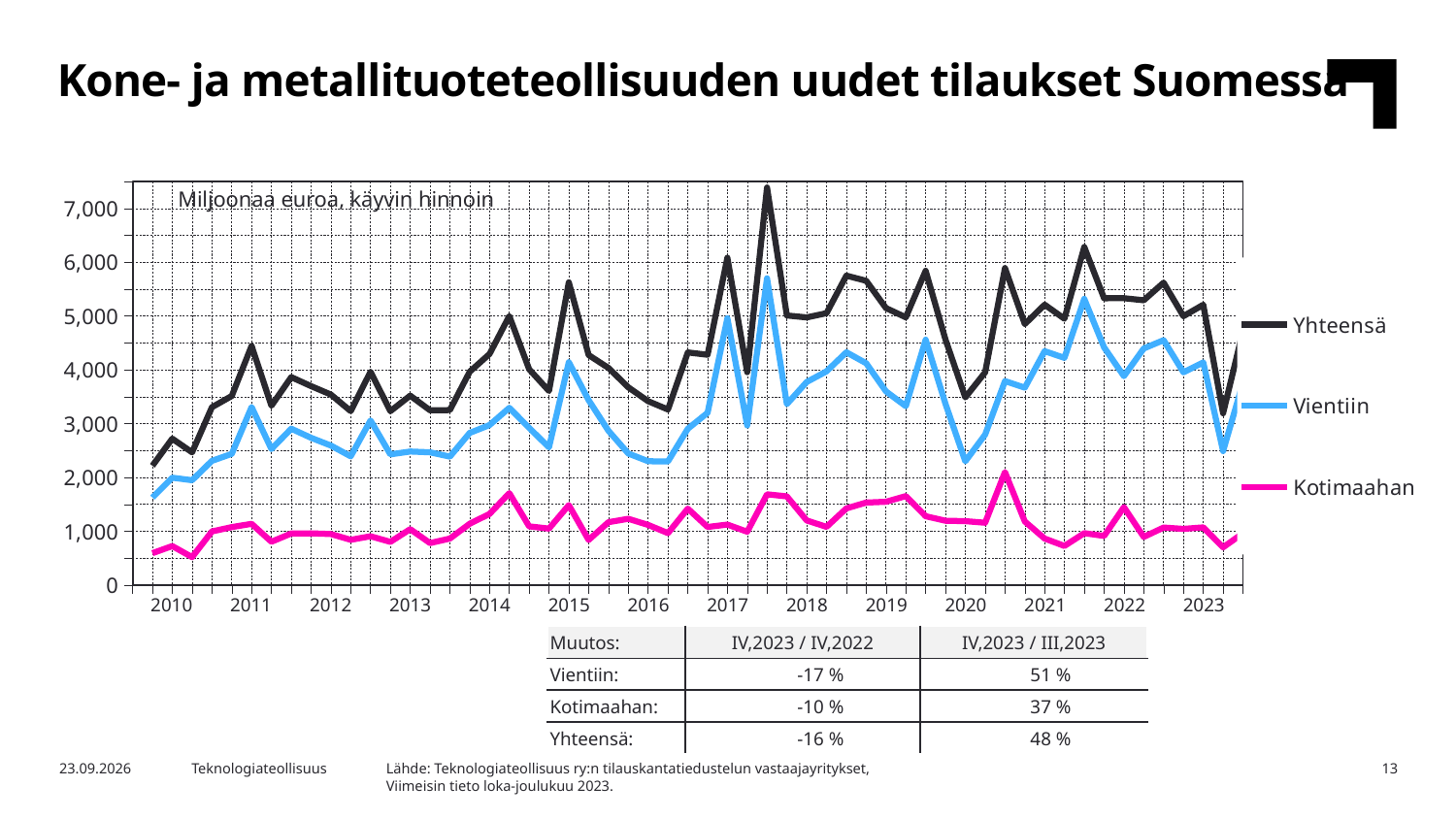
Is the peak value of the Vientiin line in 2017 greater or less than 5,000? greater Which series has the lowest values throughout the chart? Kotimaahan What kind of chart is shown on the slide? line chart Is the value of the Vientiin line at the start of 2010 greater or less than 2,000? less Which series has the highest values throughout the chart? Yhteensä Which series is plotted with the black line? Yhteensä Which series is larger in 2021, Vientiin or Kotimaahan? Vientiin How many series does the chart legend list? 3 What unit is stated in the chart's subtitle? Miljoonaa euroa, käyvin hinnoin How many year labels are shown on the x axis? 14 Is the peak value of the Yhteensä line in 2017 greater or less than 7,000? greater